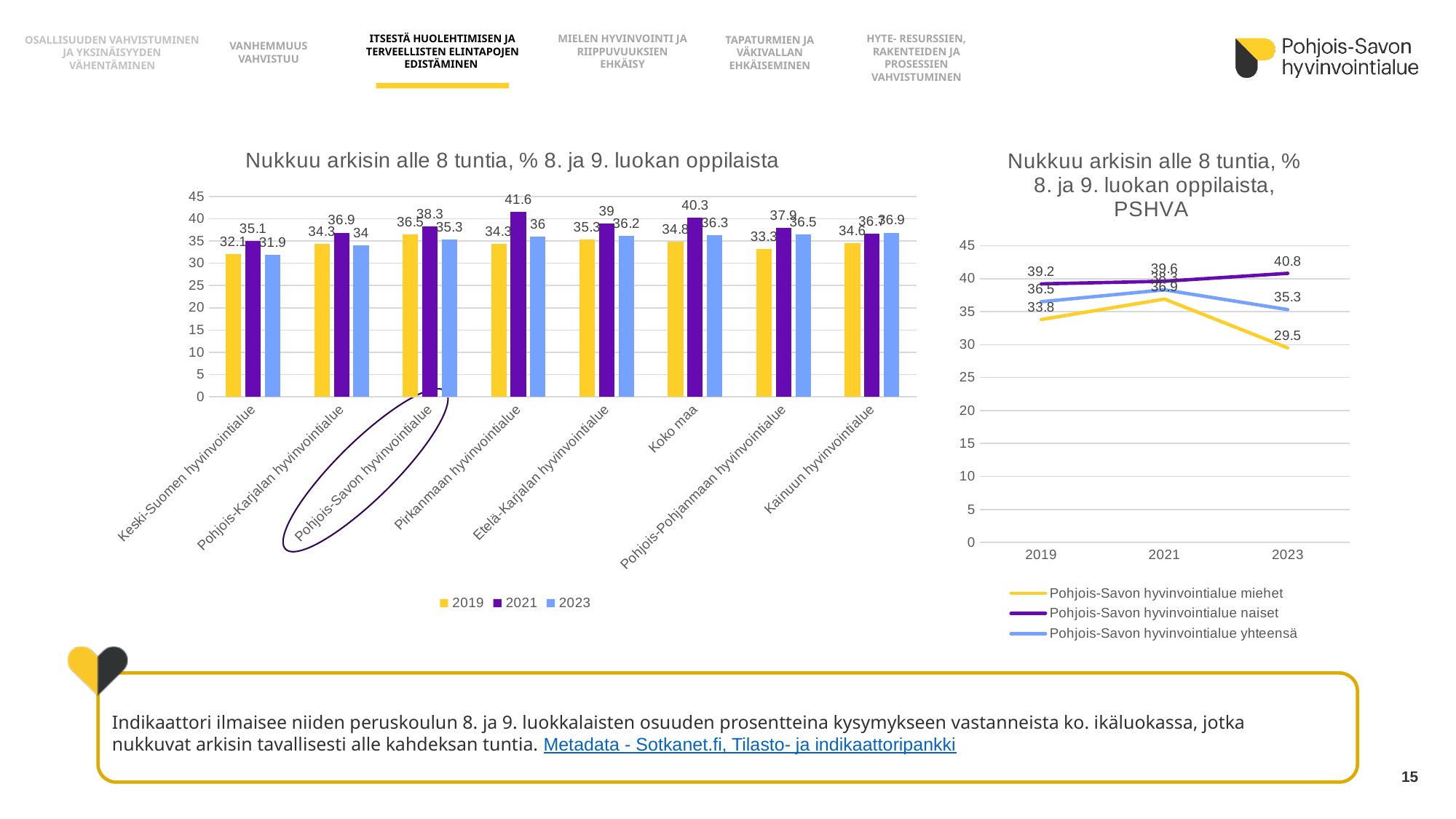
How many series does the legend of the left bar chart list? 3 In the PSHVA line chart on the right, what is the 2023 value for Pohjois-Savon hyvinvointialue miehet? 29.5 What kind of chart is the chart on the left of the slide? Bar chart In the left bar chart, which category has the highest 2021 value? Pirkanmaan hyvinvointialue In the left bar chart, which category has the lowest 2023 value? Keski-Suomen hyvinvointialue In the left bar chart, what is the difference between the 2021 and 2023 values for Pohjois-Savon hyvinvointialue? 3 What kind of chart is the PSHVA chart on the right of the slide? Line chart In the PSHVA line chart on the right, does the value for Pohjois-Savon hyvinvointialue miehet rise or fall from 2021 to 2023? Fall How many categories are shown on the x axis of the left bar chart? 8 In the left bar chart, what is the 2019 value for Koko maa? 34.8 In the left bar chart, what is the 2021 value for Pirkanmaan hyvinvointialue? 41.6 In the PSHVA line chart on the right, which is larger in 2019: the value for naiset or for miehet? Naiset